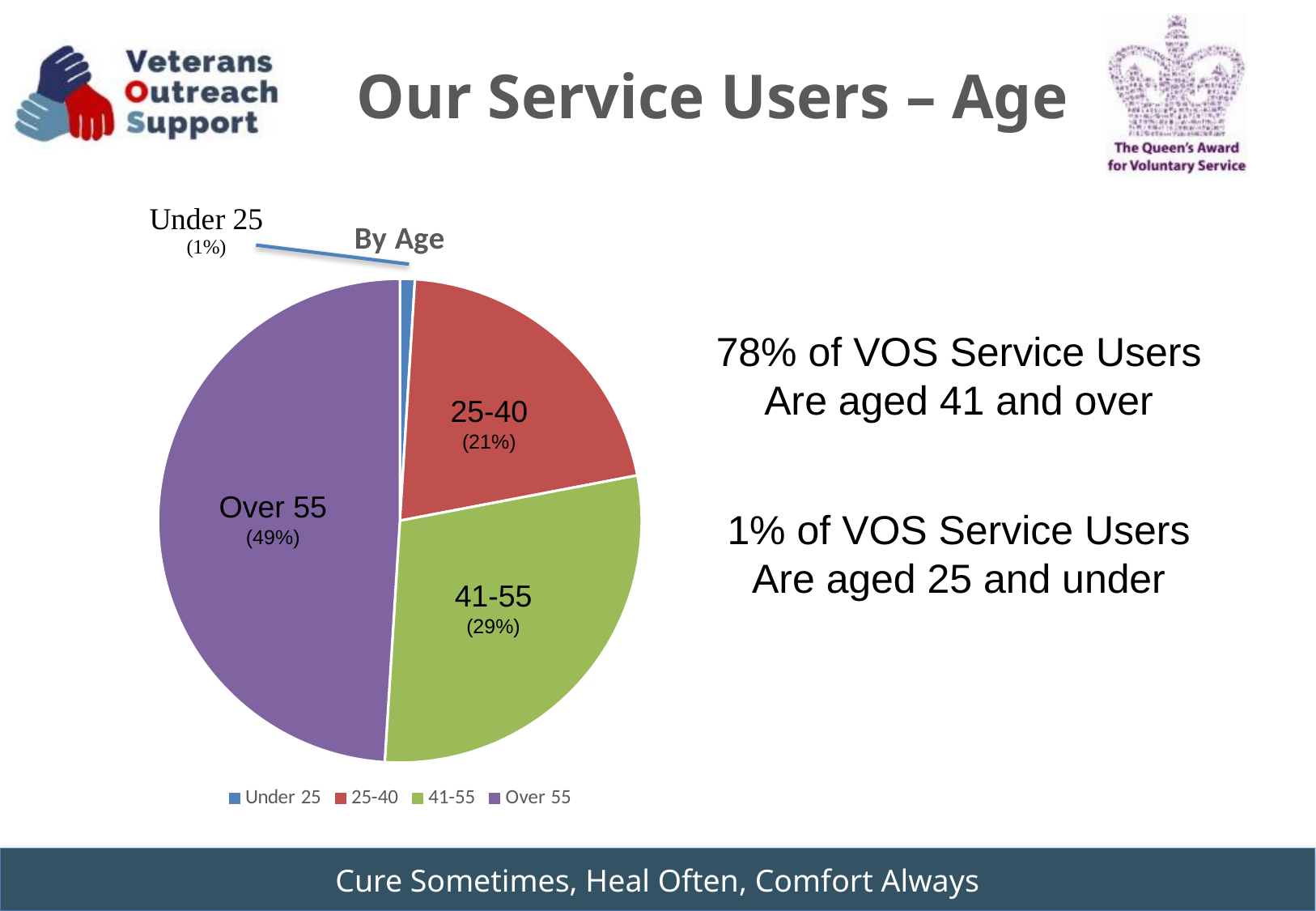
What is the title of the chart? By Age What colour is the Over 55 slice? Purple Which age group has the largest share of service users? Over 55 What share of service users are Under 25? 1% What share of service users are aged Over 55? 49% Which age group has the smallest share of service users? Under 25 What share of service users are aged 41-55? 29% What is the difference in percentage points between the Over 55 and 41-55 shares? 20 What kind of chart is shown on the slide? Pie chart Which is larger, the share for 25-40 or the share for 41-55? 41-55 What share of service users are aged 25-40? 21% How many age groups are shown in the pie chart? 4